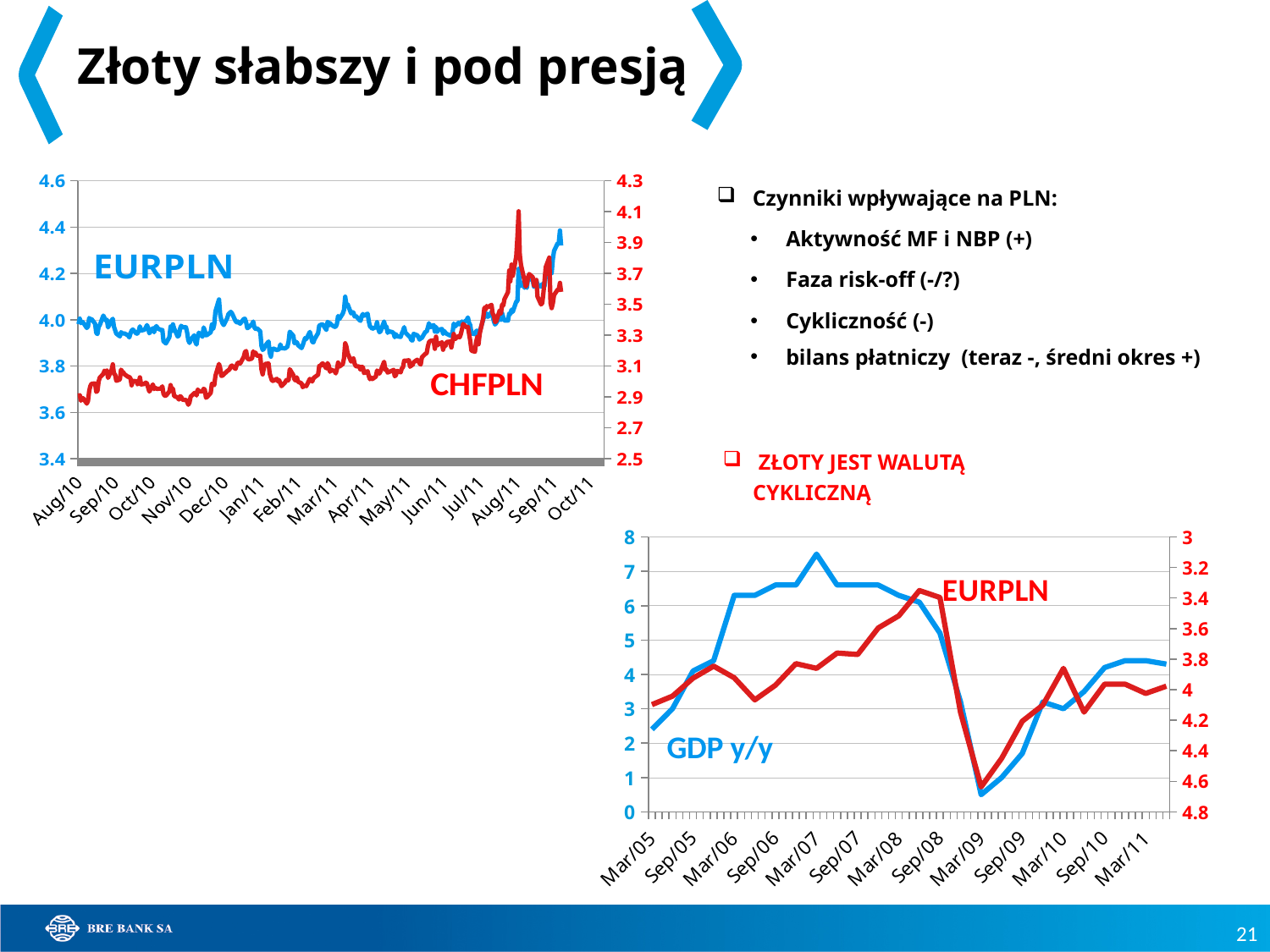
On the top-left chart, is the CHFPLN value in Aug/10 greater or less than 3.1 on the right axis? less On the top-left chart, which series is labelled in red? CHFPLN What kind of chart is the top-left chart showing EURPLN and CHFPLN? line chart On the bottom-right chart, which axis (left or right) does the EURPLN series use? right On the top-left chart, is the EURPLN value in Aug/10 greater or less than 4.2? less On the top-left chart, does the CHFPLN line rise or fall overall from Aug/10 to Sep/11? rise On the top-left chart, is the EURPLN value in Aug/10 greater or less than 3.8? greater What kind of chart is the bottom-right chart showing GDP y/y and EURPLN? line chart On the bottom-right chart, does the GDP y/y line rise or fall from Mar/07 to Mar/09? fall How many series are plotted on the top-left chart (EURPLN/CHFPLN)? 2